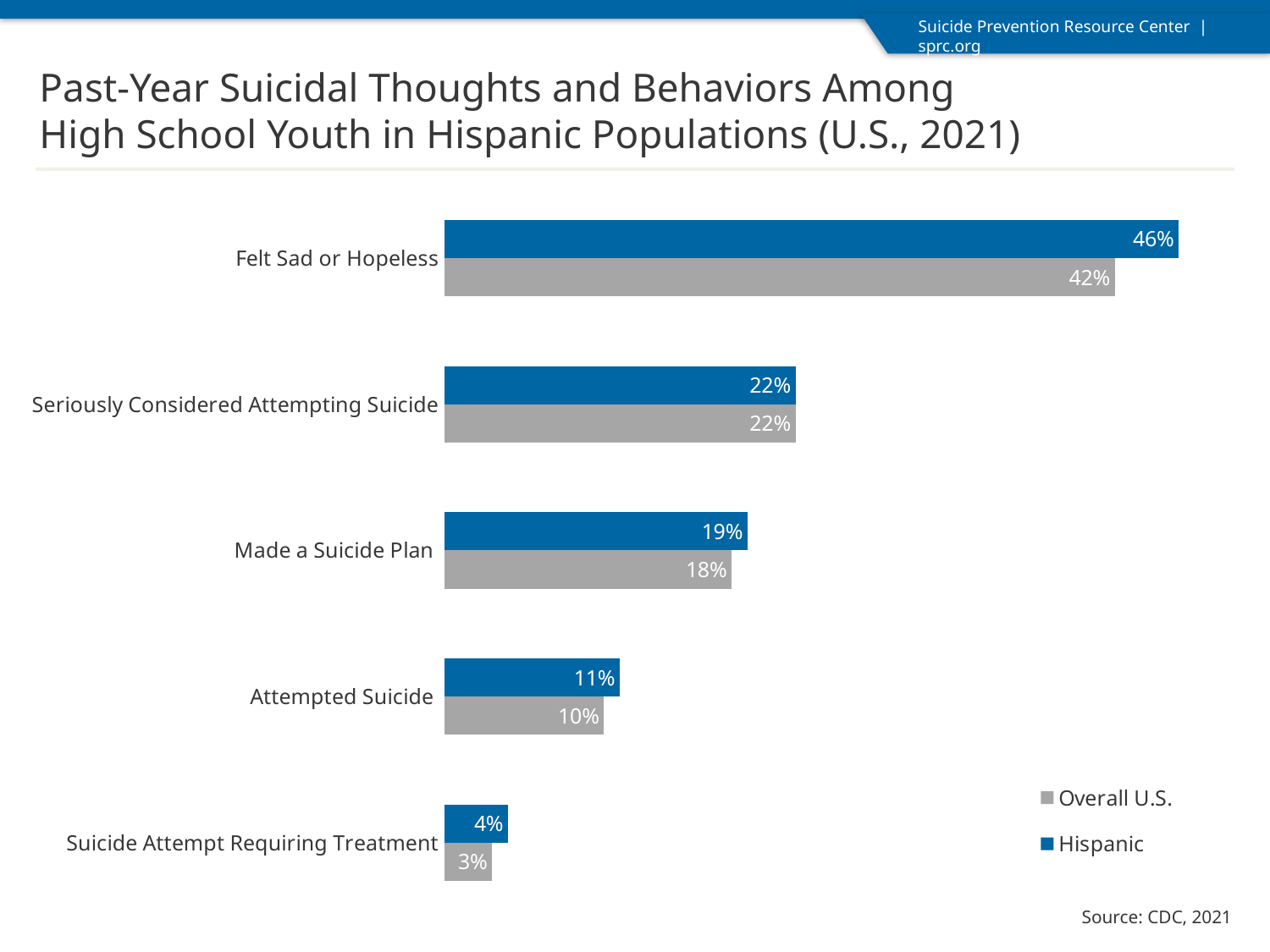
What is the Overall U.S. value for Attempted Suicide? 10% How many categories are shown on the chart? 5 Which category has the lowest Overall U.S. value? Suicide Attempt Requiring Treatment How many series does the legend list? 2 Which category has the highest Hispanic value? Felt Sad or Hopeless What is the Hispanic value for Felt Sad or Hopeless? 46% What is the difference between the Hispanic and Overall U.S. values for Felt Sad or Hopeless? 4% Which series is shown in blue? Hispanic What kind of chart is shown on the slide? Bar chart What is the Hispanic value for Suicide Attempt Requiring Treatment? 4% Which is larger for Attempted Suicide, the Hispanic value or the Overall U.S. value? Hispanic What is the Overall U.S. value for Made a Suicide Plan? 18%